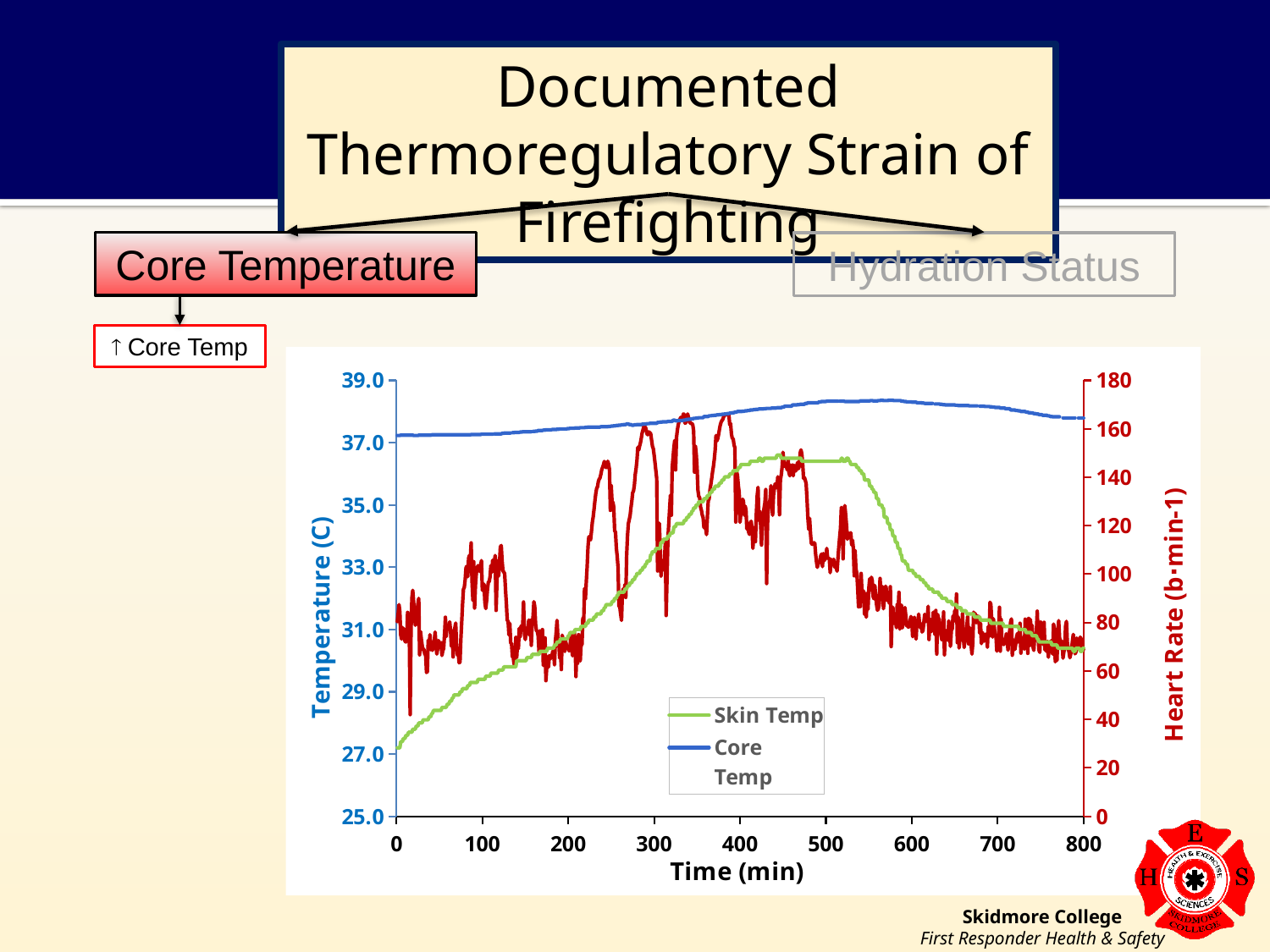
What kind of chart is shown on the slide? line chart Does the Skin Temp line rise or fall between time 0 and time 400? rise Is the highest heart rate value reached on the chart greater or less than 140? greater Is the Skin Temp value at time 450 greater or less than 35.0? greater Does the Skin Temp line rise or fall between time 550 and time 800? fall Is the Core Temp value at time 500 greater or less than 39.0? less How many series does the chart's legend list? 2 What is the title of the right-hand vertical axis of the chart? Heart Rate (b·min-1) At time 0, which is higher: Core Temp or Skin Temp? Core Temp What is the title of the x axis of the chart? Time (min)